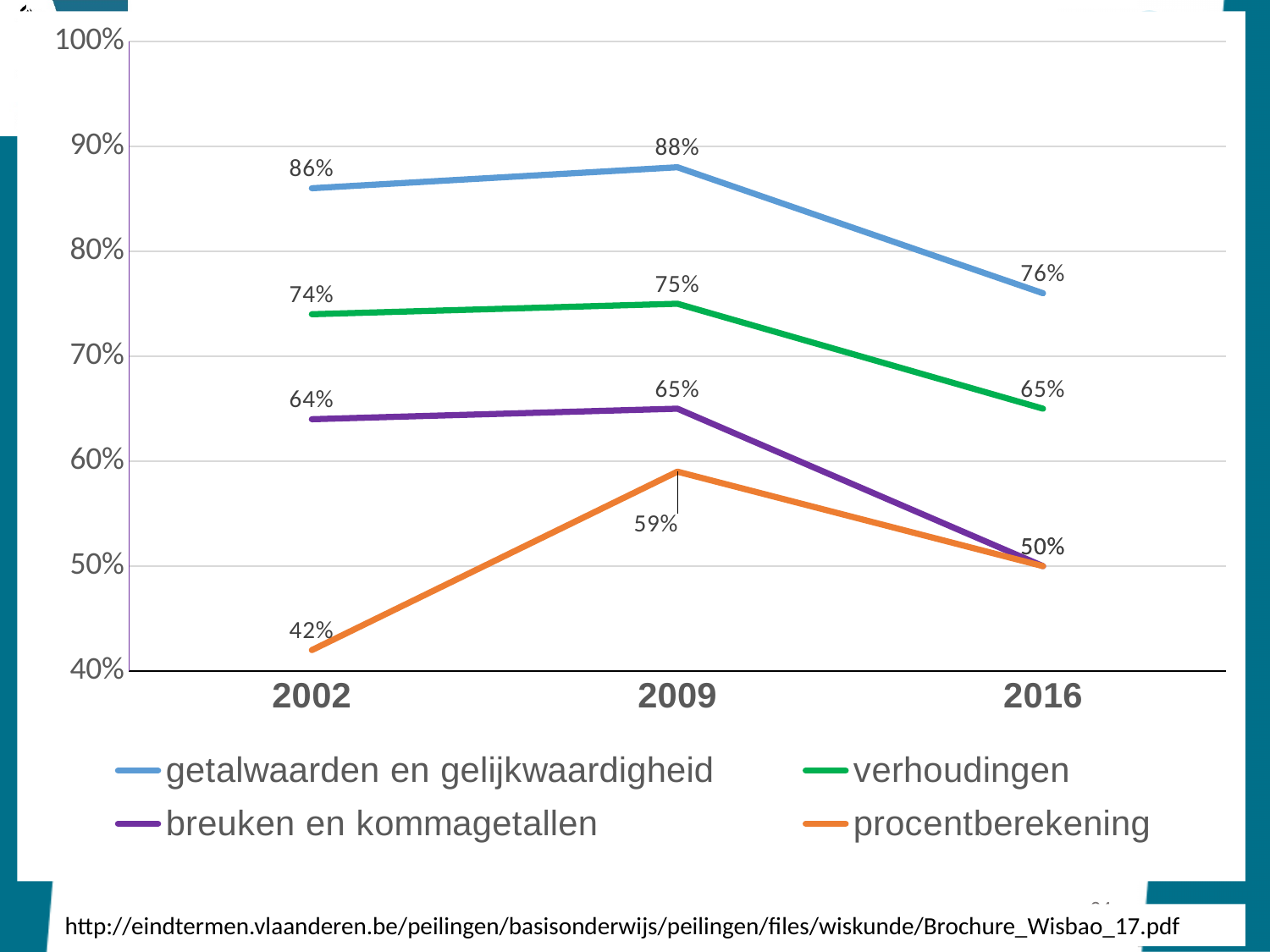
What is the difference between the 2009 and 2016 values for getalwaarden en gelijkwaardigheid? 12% What kind of chart is shown on the slide? line chart Does the value for procentberekening rise or fall from 2002 to 2009? rise Which series has the lowest value in 2002? procentberekening What is the value for procentberekening in 2002? 42% What is the value for breuken en kommagetallen in 2009? 65% What is the value for verhoudingen in 2016? 65% Which series has the highest value in 2002? getalwaarden en gelijkwaardigheid Which is larger: verhoudingen in 2002 or breuken en kommagetallen in 2009? verhoudingen in 2002 What is the value for getalwaarden en gelijkwaardigheid in 2009? 88% How many series does the legend list? 4 How many years are shown on the x axis? 3